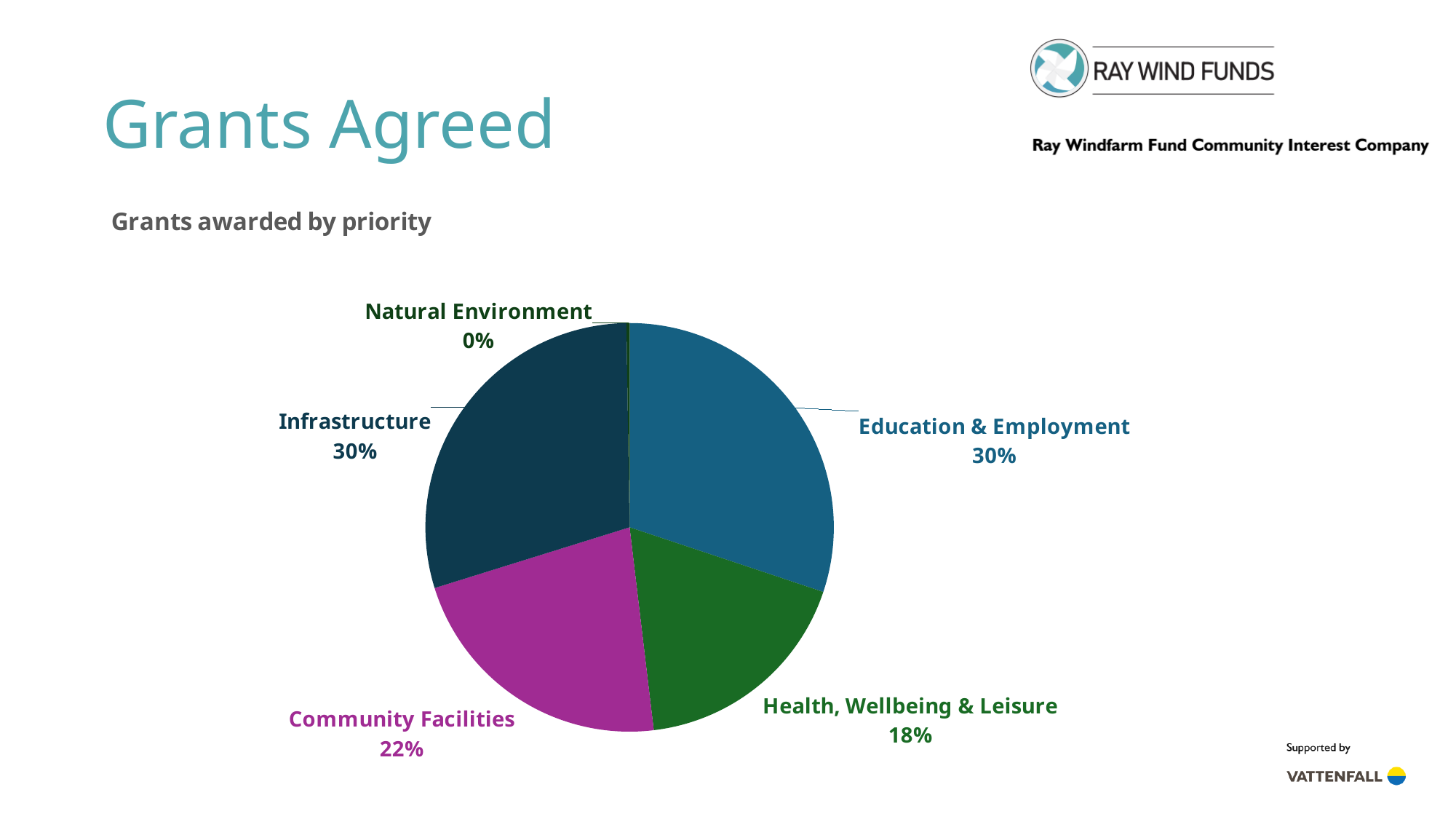
What share of grants was awarded to Infrastructure? 30% What share of grants was awarded to Natural Environment? 0% Which received a larger share of grants, Community Facilities or Health, Wellbeing & Leisure? Community Facilities How many priority categories are shown in the pie chart? 5 What is the difference in percentage points between Infrastructure and Community Facilities? 8 percentage points Which priority received the smallest share of grants? Natural Environment What share of grants was awarded to Education & Employment? 30% What is the title of the chart? Grants awarded by priority What is the difference in percentage points between Community Facilities and Health, Wellbeing & Leisure? 4 percentage points What share of grants was awarded to Community Facilities? 22% What share of grants was awarded to Health, Wellbeing & Leisure? 18% What kind of chart is shown on the slide? Pie chart